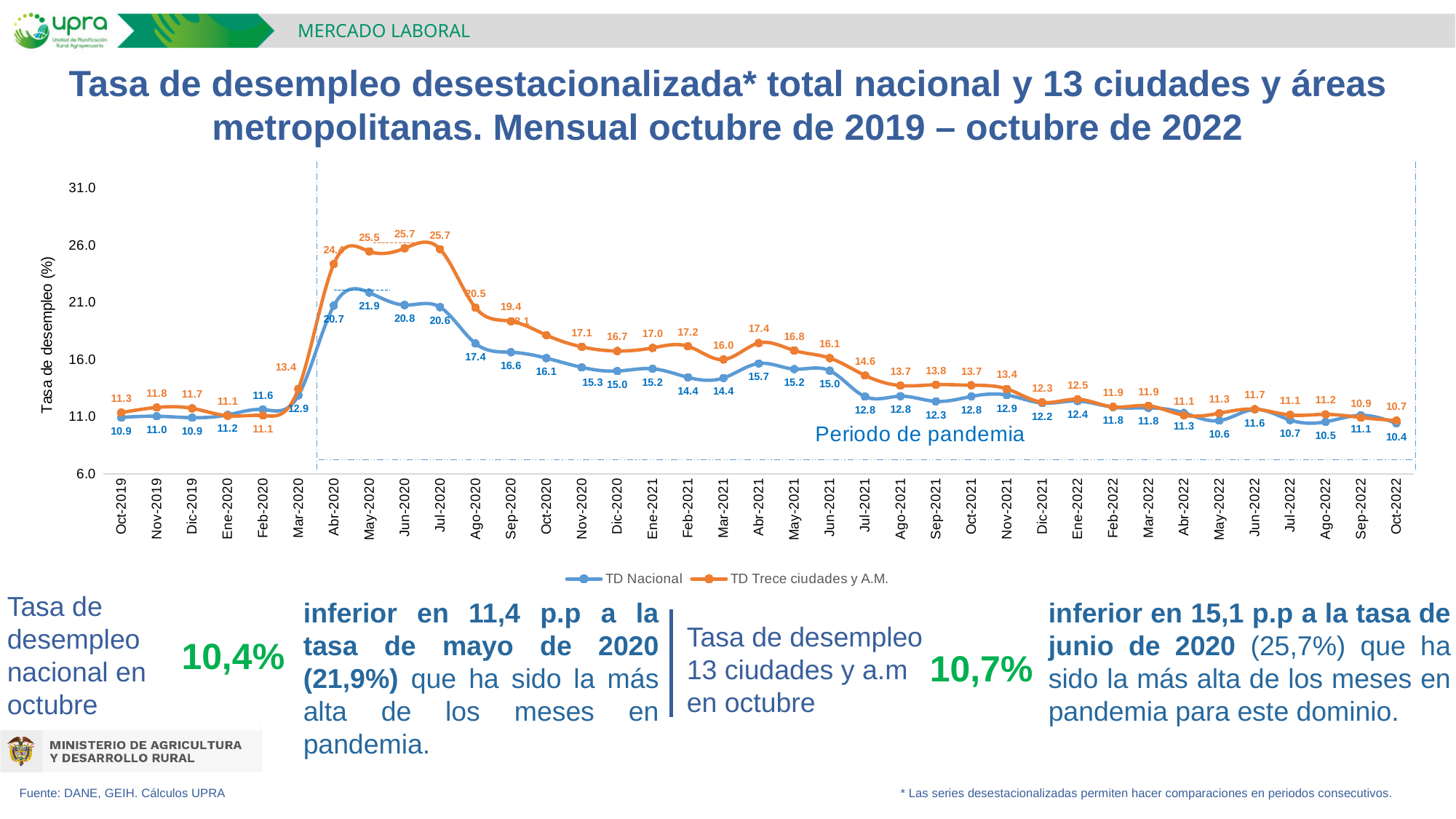
What label is written inside the dashed box on the chart? Periodo de pandemia Which series has the higher value in Abr-2021, TD Nacional or TD Trece ciudades y A.M.? TD Trece ciudades y A.M. In which month does TD Nacional reach its highest value? May-2020 How many series does the legend list? 2 Is the value of TD Trece ciudades y A.M. for Ago-2020 greater or less than 16.0? greater What is the difference between TD Trece ciudades y A.M. and TD Nacional in Jul-2021? 1.8 What is the value of TD Trece ciudades y A.M. for Jun-2020? 25.7 What is the value of TD Nacional for May-2020? 21.9 How many months are plotted on the x axis? 37 What type of chart is shown on the slide? line chart Does TD Nacional rise or fall from Jun-2021 to Jul-2021? fall What is the value of TD Nacional for Oct-2022? 10.4